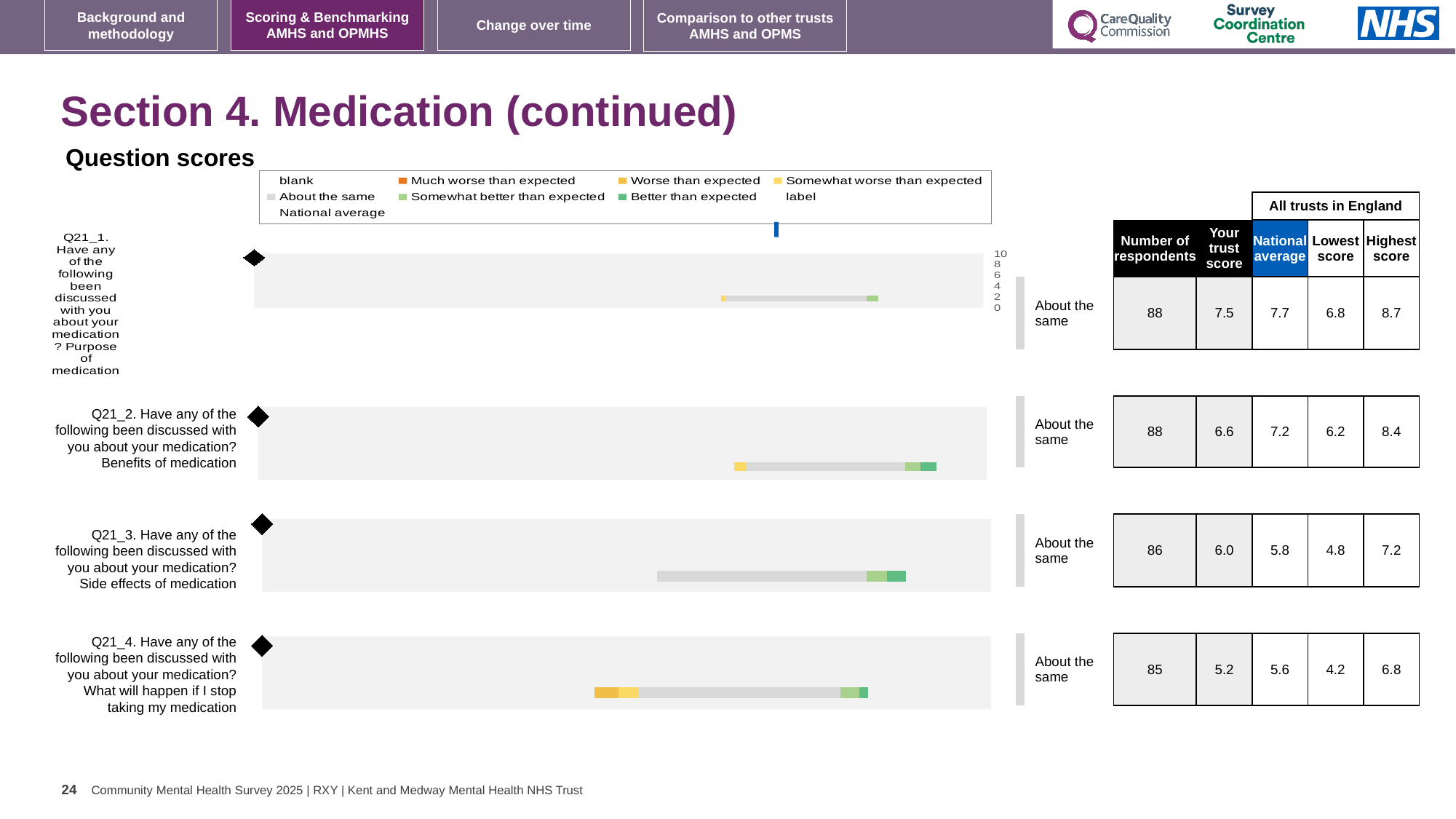
In the table next to the Q21_3 chart, what is the number of respondents? 86 Which question has the lowest national average in the tables? Q21_4 What benchmark category label is shown to the right of the Q21_2 chart? About the same In the table next to the Q21_1 chart, what is the trust score? 7.5 In the table next to the Q21_4 chart, what is the national average? 5.6 For Q21_2, what is the difference between the highest score and the lowest score in the table? 2.2 What colour does the legend use for 'Much worse than expected'? orange How many question charts are shown on the slide? 4 How many entries does the chart legend list? 9 For Q21_3, which is larger: the trust score or the national average? trust score What kind of chart is used to show the benchmark range for Q21_1? bar chart Which question has the highest trust score in the tables? Q21_1